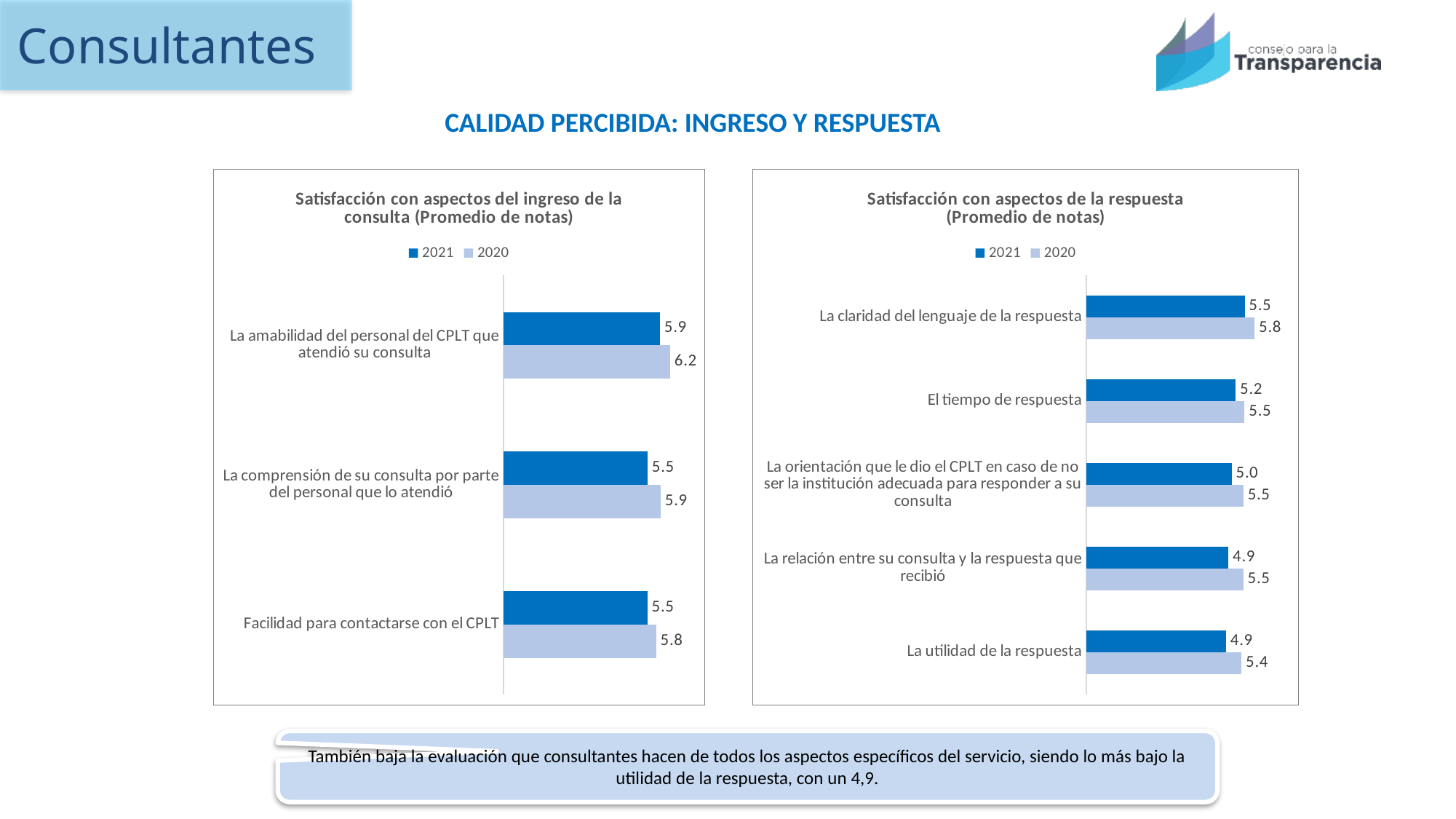
How many categories are shown in the right chart (Satisfacción con aspectos de la respuesta)? 5 How many series does the legend of the left chart (Satisfacción con aspectos del ingreso de la consulta) list? 2 In the left chart (Satisfacción con aspectos del ingreso de la consulta), which category has the highest 2020 value? La amabilidad del personal del CPLT que atendió su consulta What type of chart is the left chart (Satisfacción con aspectos del ingreso de la consulta)? Bar chart In the right chart (Satisfacción con aspectos de la respuesta), what is the difference between the 2020 and 2021 values for 'La relación entre su consulta y la respuesta que recibió'? 0.6 In the right chart (Satisfacción con aspectos de la respuesta), which category has the highest 2021 value? La claridad del lenguaje de la respuesta In the right chart (Satisfacción con aspectos de la respuesta), which is larger for 'La claridad del lenguaje de la respuesta': the 2021 value or the 2020 value? 2020 In the left chart (Satisfacción con aspectos del ingreso de la consulta), what is the 2021 value for 'La amabilidad del personal del CPLT que atendió su consulta'? 5.9 In the left chart (Satisfacción con aspectos del ingreso de la consulta), what is the difference between the 2020 and 2021 values for 'La comprensión de su consulta por parte del personal que lo atendió'? 0.4 In the right chart (Satisfacción con aspectos de la respuesta), what is the 2020 value for 'La utilidad de la respuesta'? 5.4 In the left chart (Satisfacción con aspectos del ingreso de la consulta), what is the 2020 value for 'Facilidad para contactarse con el CPLT'? 5.8 In the right chart (Satisfacción con aspectos de la respuesta), what is the 2021 value for 'El tiempo de respuesta'? 5.2